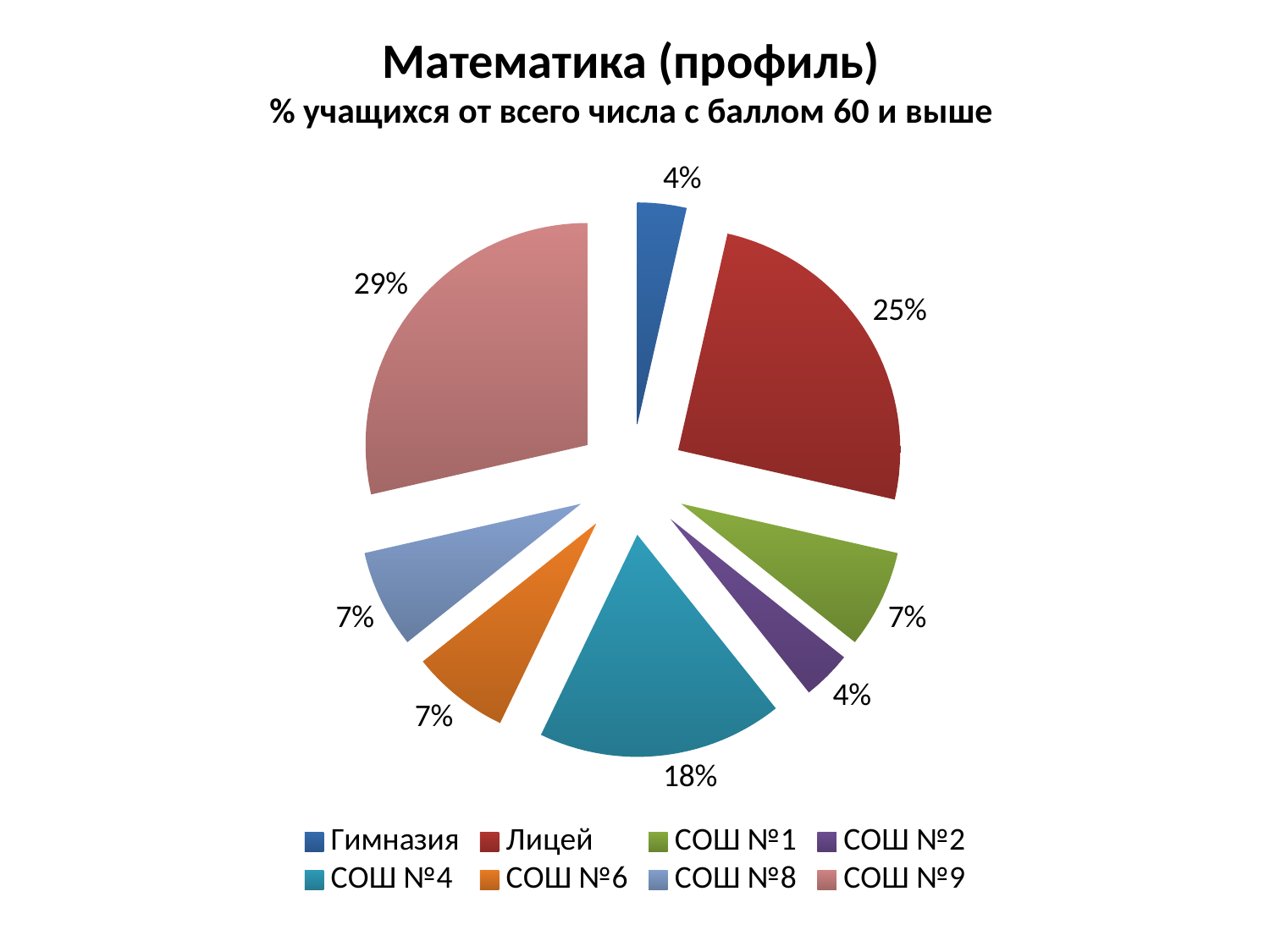
What kind of chart is shown on the slide? pie chart What is the difference between the shares of СОШ №4 and СОШ №1? 11% What share of the pie does Гимназия have? 4% What share of the pie does СОШ №6 have? 7% What share of the pie does СОШ №4 have? 18% What share of the pie does Лицей have? 25% How many schools are listed in the legend? 8 What is the title of the chart? Математика (профиль) Which is larger, the slice for Лицей or the slice for СОШ №4? Лицей Which school has the largest slice of the pie? СОШ №9 What is the difference between the shares of СОШ №9 and Лицей? 4% What share of the pie does СОШ №9 have? 29%